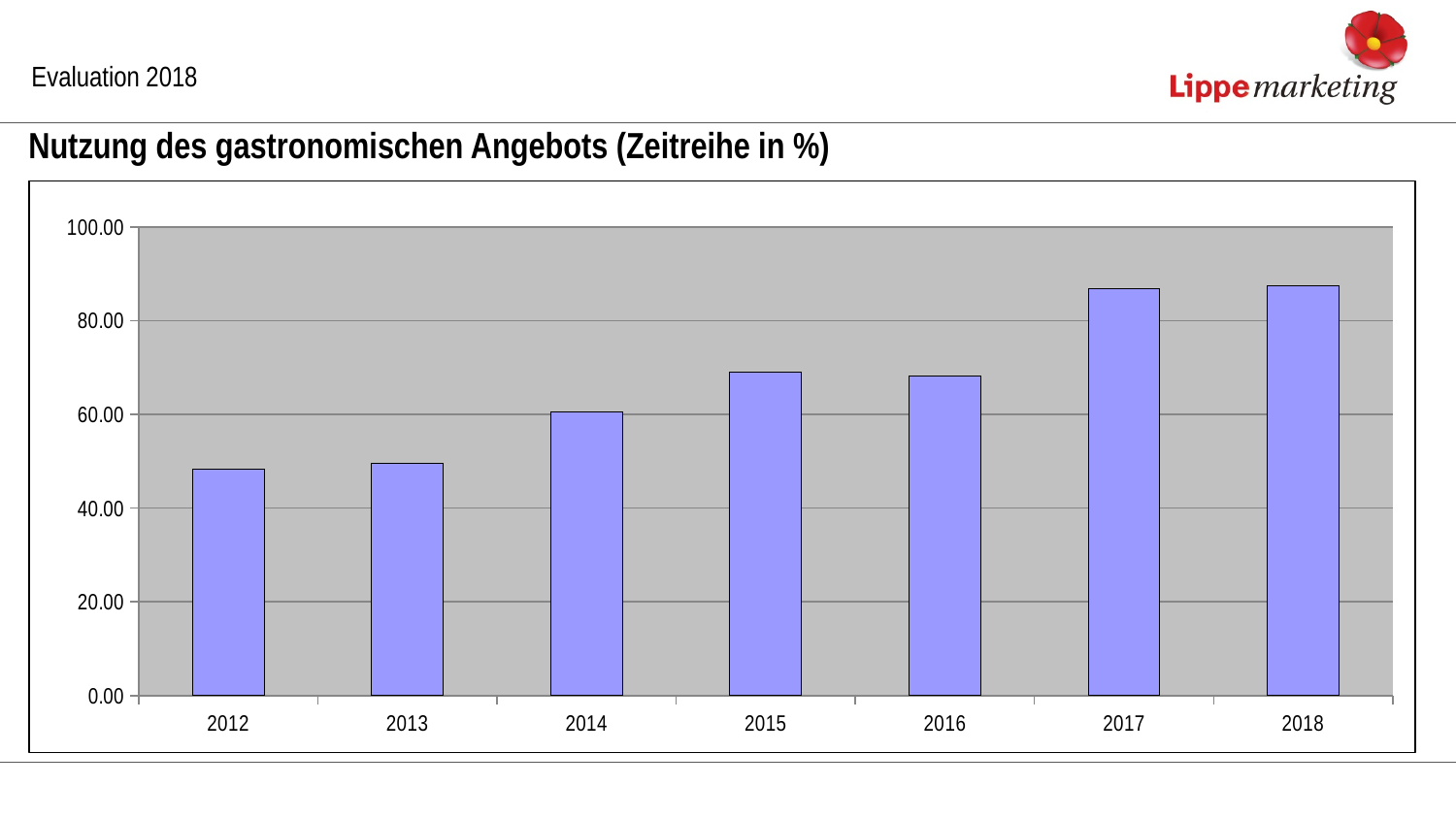
Which has the larger value, 2014 or 2015? 2015 Is the value for 2014 greater or less than 80? less Do the values generally rise or fall from 2012 to 2018? rise Which has the larger value, 2012 or 2017? 2017 What kind of chart is shown on the slide? bar chart How many years are shown on the x axis of the chart? 7 Is the value for 2012 greater or less than 60? less Is the value for 2017 greater or less than 80? greater What is the title of the chart on the slide? Nutzung des gastronomischen Angebots (Zeitreihe in %)